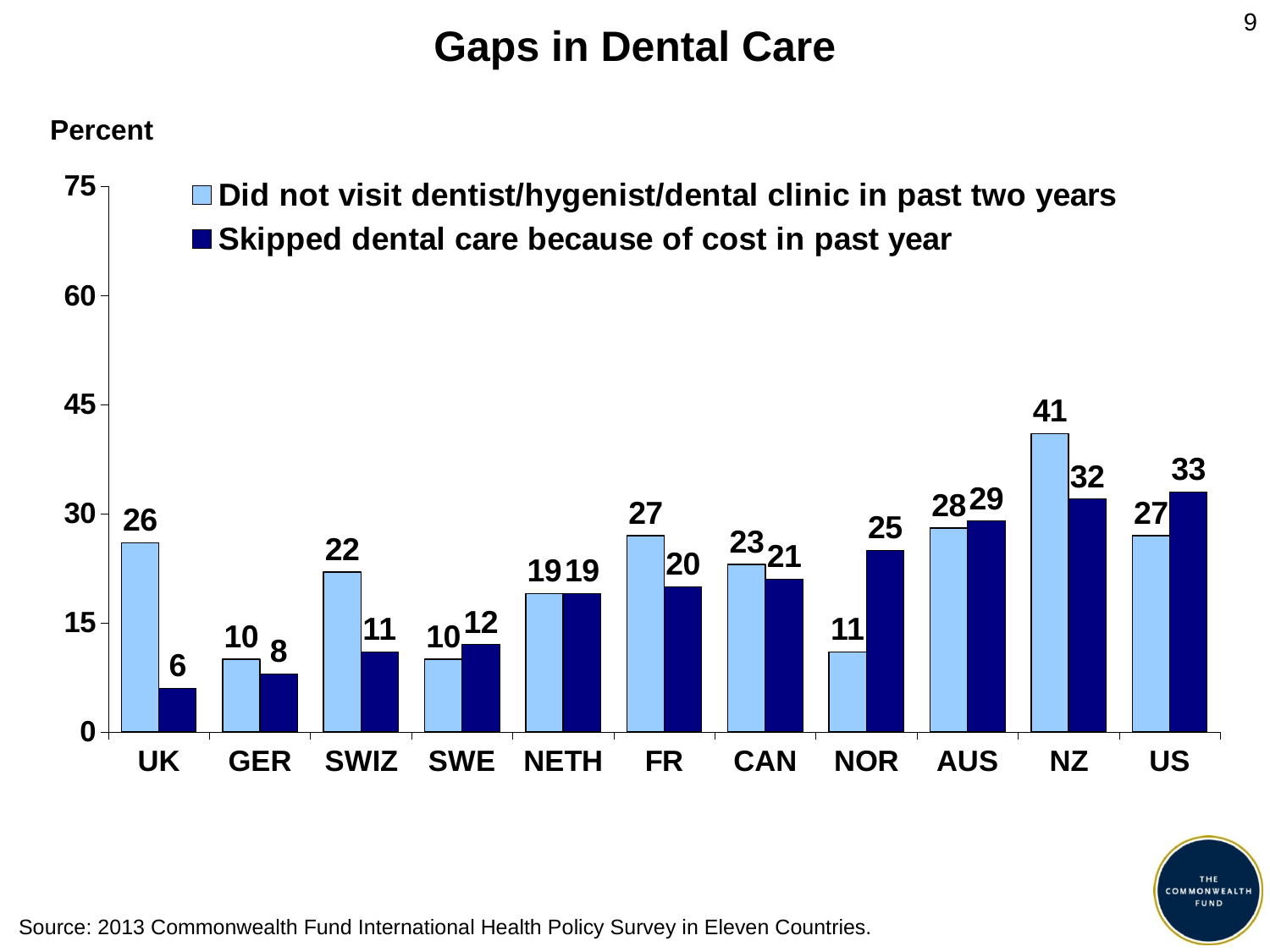
Which is larger for NOR: the share that did not visit a dentist in the past two years or the share that skipped dental care because of cost? Skipped dental care because of cost in past year What is the difference between the US and NZ values for 'Skipped dental care because of cost in past year'? 1 Is the value for NZ 'Did not visit dentist/hygenist/dental clinic in past two years' greater or less than 30? greater What is the title of the chart? Gaps in Dental Care What is the difference between the two values shown for the UK? 20 How many series does the legend list? 2 Which country has the lowest value for 'Skipped dental care because of cost in past year'? UK What percent of people in the UK did not visit a dentist/hygenist/dental clinic in the past two years? 26 How many countries are shown on the x axis? 11 Which country has the highest value for 'Did not visit dentist/hygenist/dental clinic in past two years'? NZ What kind of chart is shown on the slide? Bar chart What percent of people in the US skipped dental care because of cost in the past year? 33